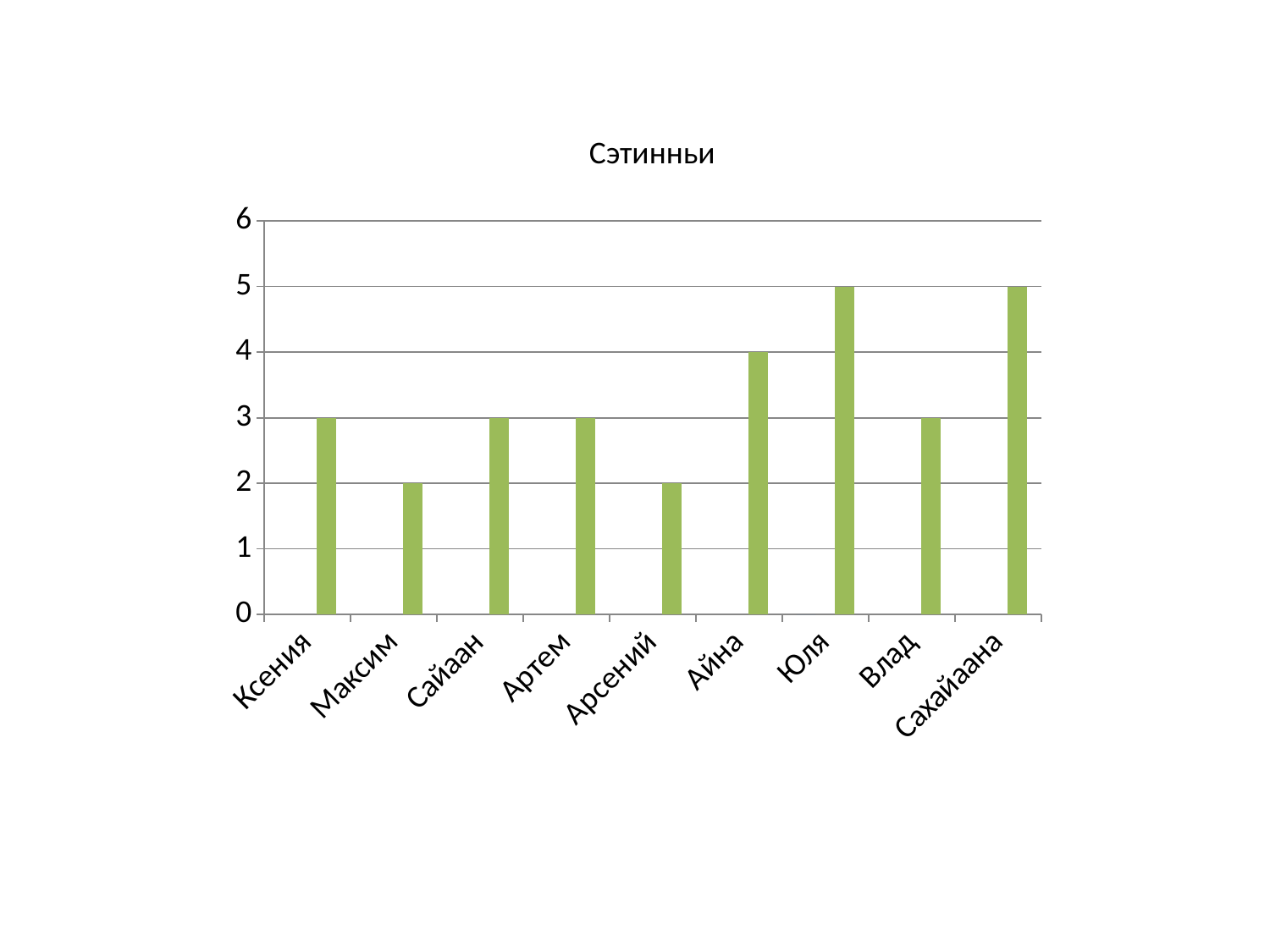
What is the difference between the values for Юля and Максим? 3 How many categories are shown on the x axis? 9 What is the value for Айна? 4 Is the value for Сахайаана greater or less than 4? greater Which two categories share the highest value on the chart? Юля and Сахайаана What is the value for Ксения? 3 What is the title of the chart? Сэтинньи What is the value for Арсений? 2 What is the difference between the values for Айна and Арсений? 2 What kind of chart is shown on the slide? Bar chart What is the value for Юля? 5 Which is larger, the value for Айна or the value for Влад? Айна